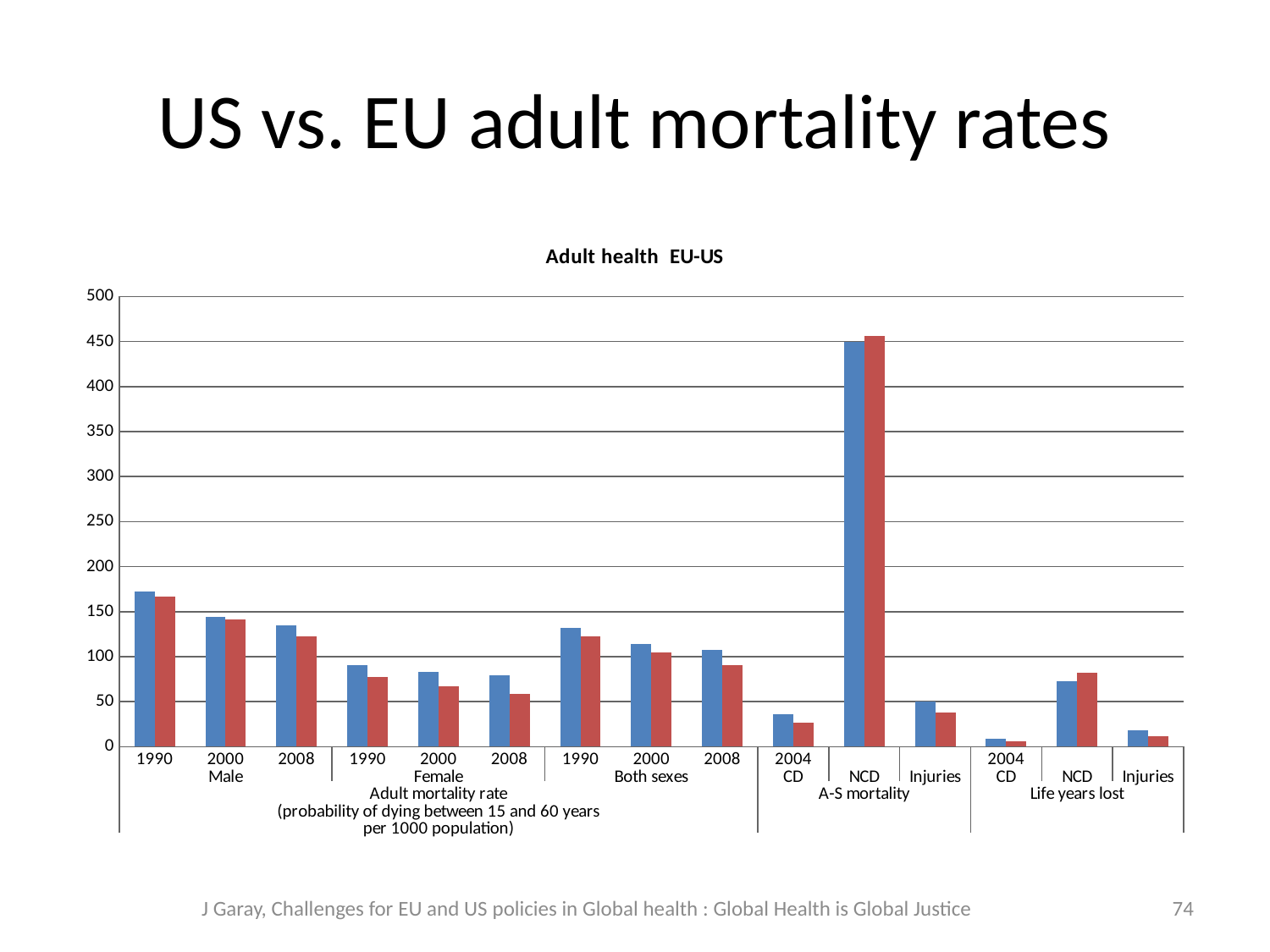
Is the value of the blue bar for NCD under A-S mortality greater or less than 400? greater Which category has the shortest bars in the chart? CD (Life years lost) What is the title of the chart? Adult health EU-US Do the Female adult mortality rate bars rise or fall from 1990 to 2008? fall Which category has the tallest bars in the chart? NCD (A-S mortality) Is the value of the blue bar for Both sexes 1990 greater or less than 100? greater What kind of chart is shown on the slide? bar chart Which is larger, the blue bar for Male 1990 or the blue bar for Female 1990? Male 1990 Do the Male adult mortality rate bars rise or fall from 1990 to 2008? fall Is the value of the red bar for CD under Life years lost greater or less than 50? less How many year labels are shown under the Male group of the adult mortality rate section? 3